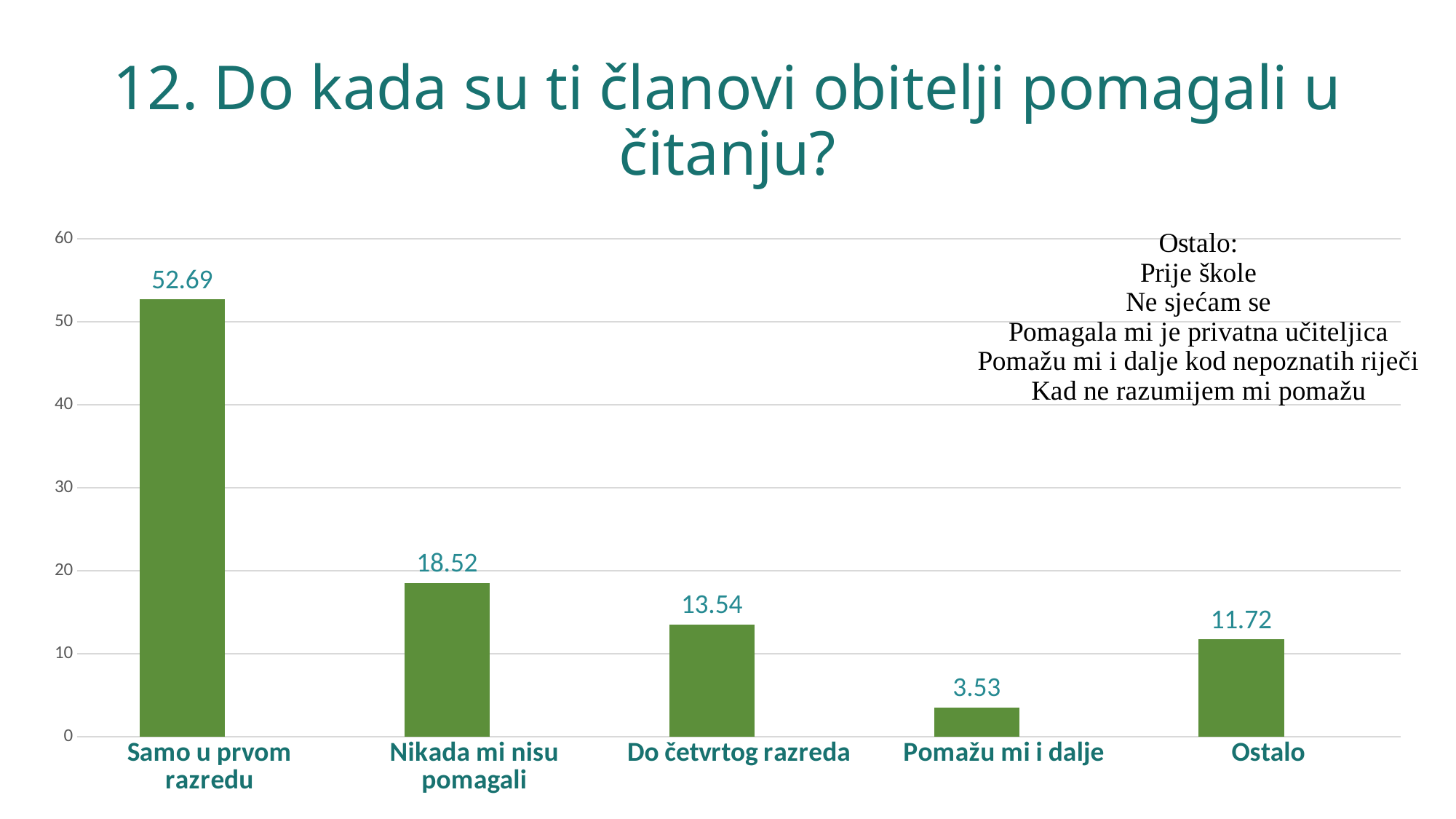
What is the value for "Pomažu mi i dalje"? 3.53 What is the value for "Ostalo"? 11.72 Which is larger, the value for "Do četvrtog razreda" or the value for "Ostalo"? Do četvrtog razreda What is the value for "Nikada mi nisu pomagali"? 18.52 What is the value for "Samo u prvom razredu"? 52.69 How many categories are shown on the x axis? 5 What kind of chart is shown on the slide? Bar chart What is the value for "Do četvrtog razreda"? 13.54 What is the title of the slide? 12. Do kada su ti članovi obitelji pomagali u čitanju? What is the difference between the values for "Samo u prvom razredu" and "Nikada mi nisu pomagali"? 34.17 Which category has the highest value? Samo u prvom razredu Which category has the lowest value? Pomažu mi i dalje